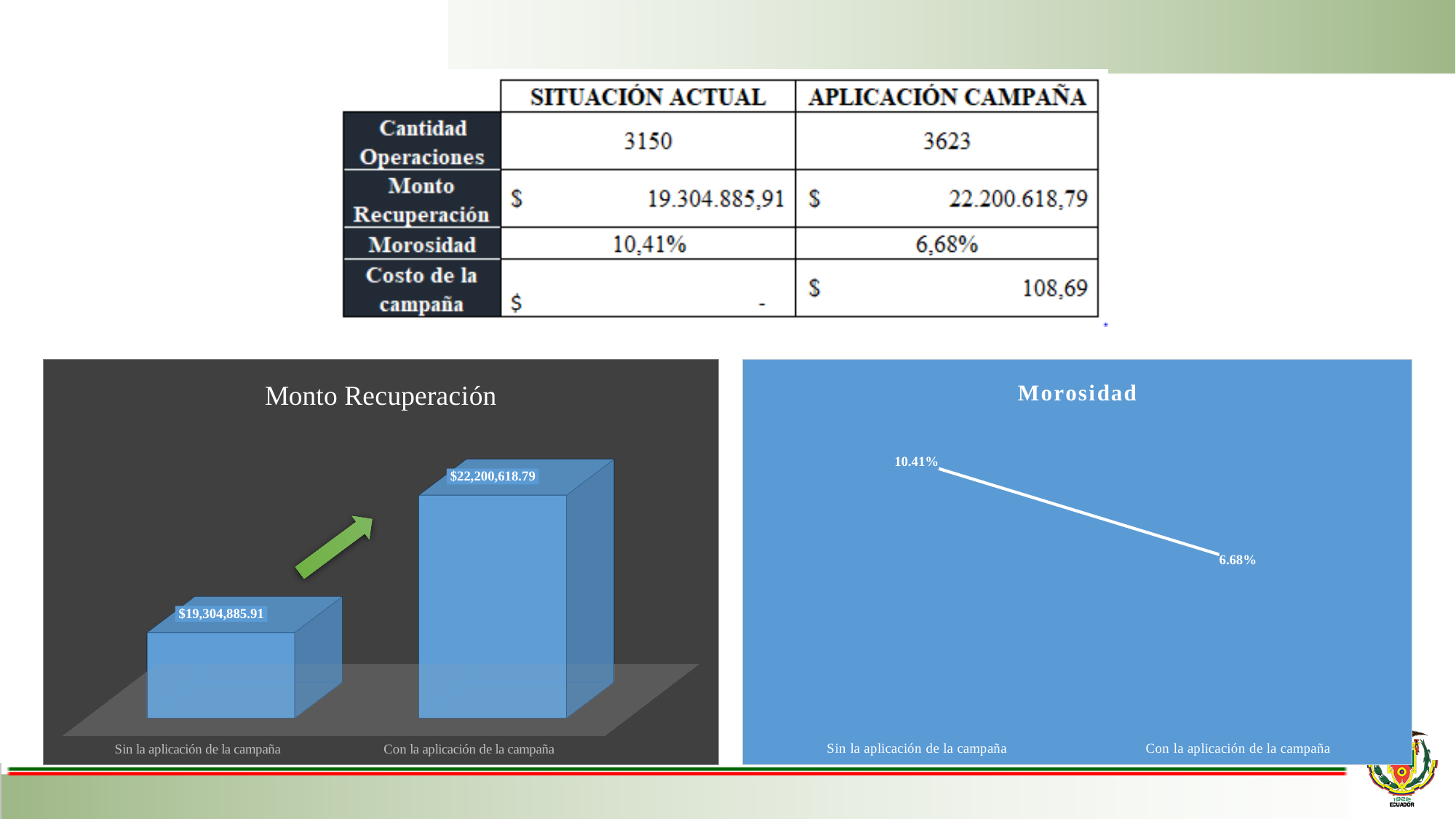
In the "Morosidad" chart, do the values rise or fall from left to right? Fall In the "Monto Recuperación" chart, what is the value for "Con la aplicación de la campaña"? $22,200,618.79 How many categories are shown in the "Monto Recuperación" chart? 2 In the "Morosidad" chart, what is the value for "Con la aplicación de la campaña"? 6.68% In the "Morosidad" chart, which category has the lowest value? Con la aplicación de la campaña What kind of chart is the "Morosidad" chart? Line chart In the "Monto Recuperación" chart, what is the value for "Sin la aplicación de la campaña"? $19,304,885.91 In the "Monto Recuperación" chart, which category has the highest value? Con la aplicación de la campaña What kind of chart is the "Monto Recuperación" chart? Bar chart In the "Monto Recuperación" chart, what is the difference between the value with the campaign and the value without the campaign? $2,895,732.88 In the "Morosidad" chart, what is the difference between the two plotted values? 3.73% In the "Morosidad" chart, what is the value for "Sin la aplicación de la campaña"? 10.41%